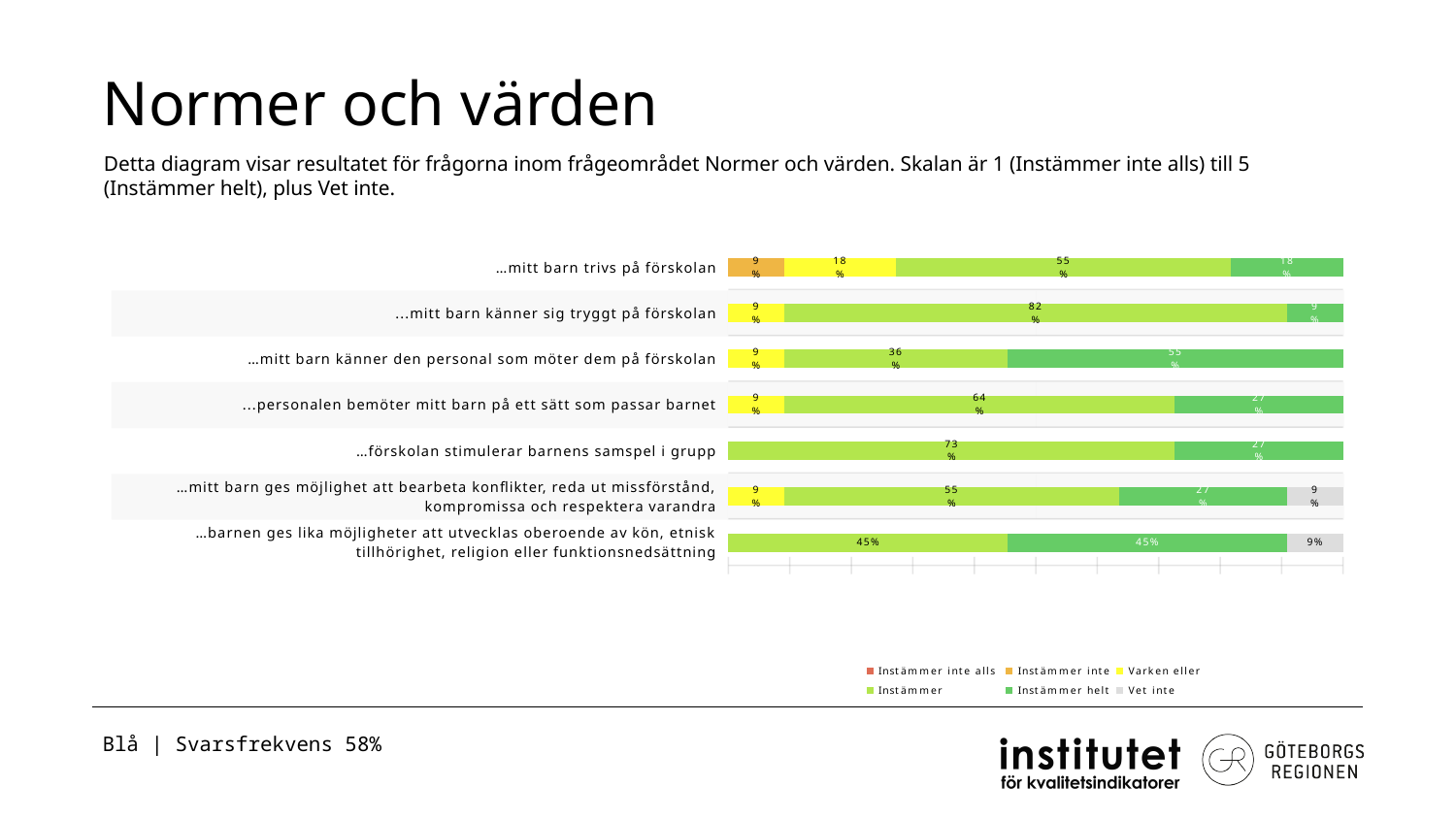
What kind of chart is shown on the slide? Stacked bar chart What is the 'Vet inte' value for '…barnen ges lika möjligheter att utvecklas oberoende av kön, etnisk tillhörighet, religion eller funktionsnedsättning'? 9% How many series does the legend list? 6 What is the 'Varken eller' value for '…mitt barn trivs på förskolan'? 18% Which is larger: the 'Instämmer' value for '…förskolan stimulerar barnens samspel i grupp' or for '…personalen bemöter mitt barn på ett sätt som passar barnet'? …förskolan stimulerar barnens samspel i grupp What is the total of the stacked bar for '…mitt barn trivs på förskolan' (9% + 18% + 55% + 18%)? 100% Which statement has the highest 'Instämmer' value? …mitt barn känner sig tryggt på förskolan What is the difference between the 'Instämmer' value (64%) and the 'Instämmer helt' value (27%) for '…personalen bemöter mitt barn på ett sätt som passar barnet'? 37% What is the 'Instämmer' value for '…mitt barn känner sig tryggt på förskolan'? 82% Which legend entry is shown in the grey colour? Vet inte How many statements (categories) are plotted in the chart? 7 What is the 'Instämmer helt' value for '…mitt barn känner den personal som möter dem på förskolan'? 55%